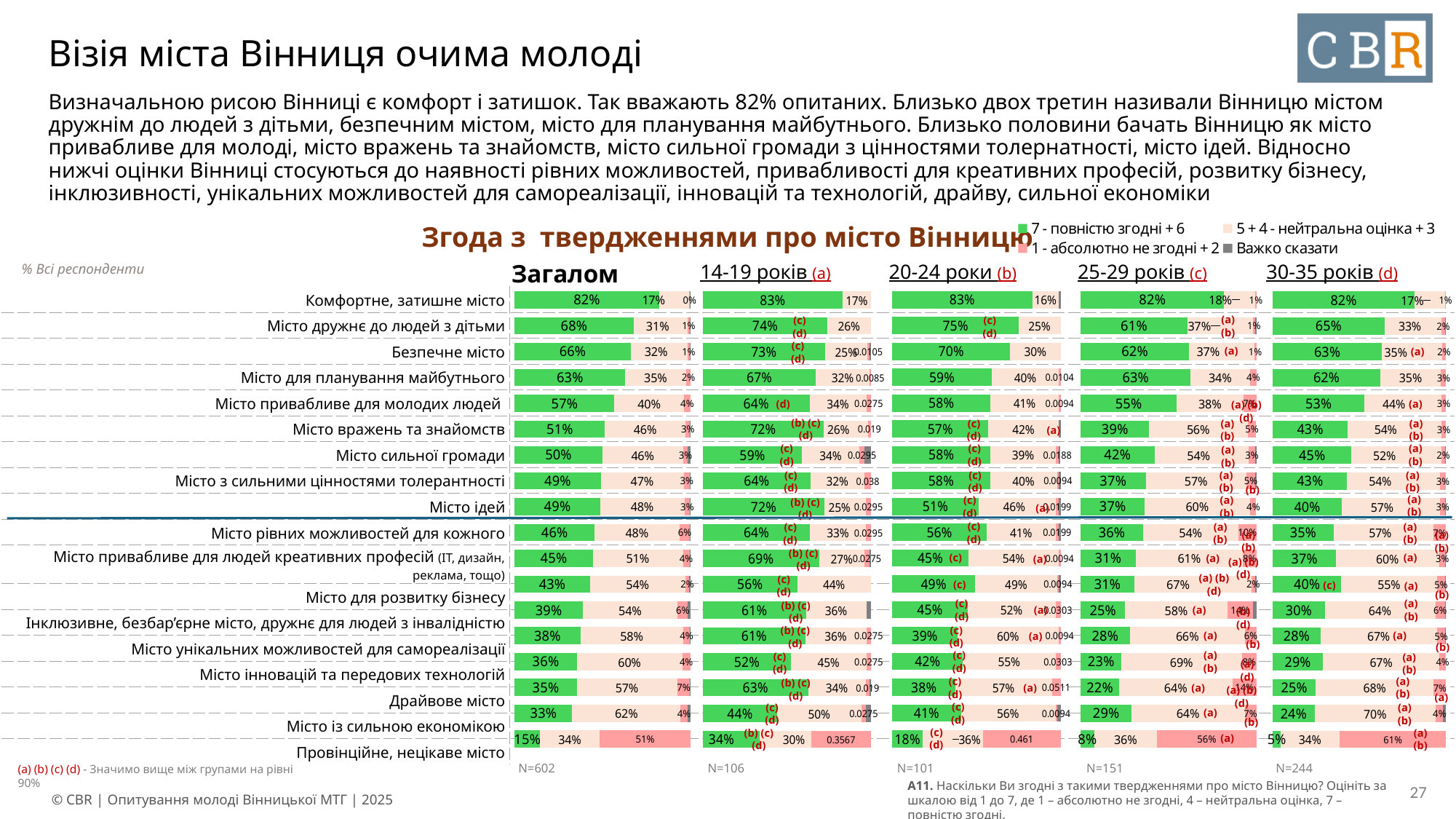
What type of chart is used to show agreement with the statements? Stacked bar chart Which group has the larger full-agreement share for "Місто вражень та знайомств": "14-19 років" or "25-29 років"? 14-19 років How many series does the legend list? 4 In the "Загалом" chart, what share of respondents fully agree (7 + 6) that Vinnytsia is a "Комфортне, затишне місто"? 82% In the "Загалом" chart, what is the neutral (5 + 4 + 3) share for "Місто із сильною економікою"? 62% How many statements (categories) are shown in the "Загалом" chart? 18 In the "25-29 років" chart, what is the disagree (1 + 2) share for "Провінційне, нецікаве місто"? 56% In the "Загалом" chart, which statement has the lowest share of full agreement (green segment)? Провінційне, нецікаве місто In the "14-19 років" chart, what share fully agree that Vinnytsia is "Місто ідей"? 72% In the "30-35 років" chart, which statement has the highest share of full agreement (green segment)? Комфортне, затишне місто What is the sample size (N) shown under the "20-24 роки" chart? N=101 In the "Загалом" chart, what is the difference between the full-agreement shares for "Комфортне, затишне місто" and "Безпечне місто"? 16 percentage points